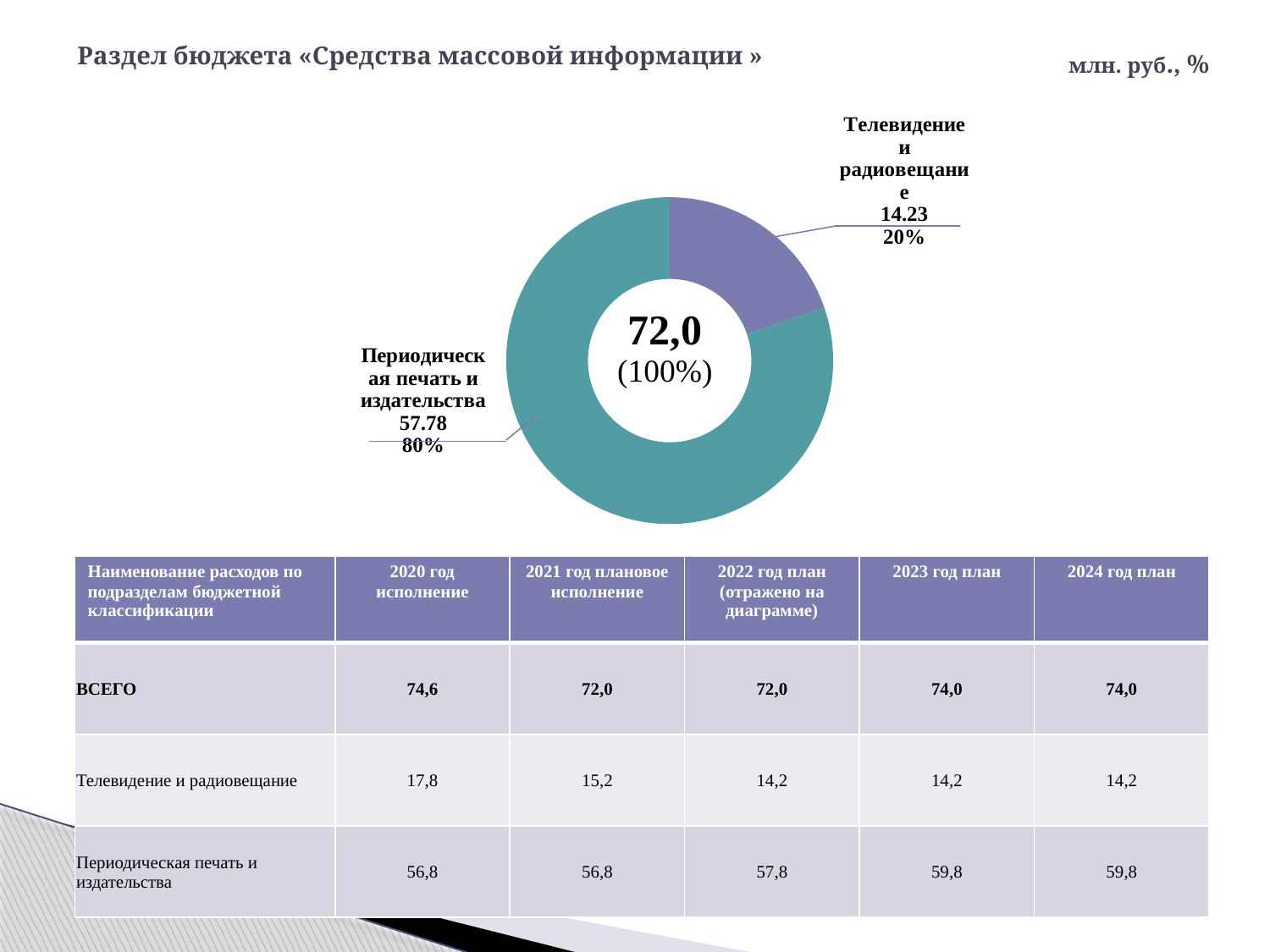
What share of the doughnut chart does Периодическая печать и издательства represent? 80% How many slices does the doughnut chart have? 2 What value is shown for Телевидение и радиовещание on the doughnut chart? 14.23 What value is shown for Периодическая печать и издательства on the doughnut chart? 57.78 What is the difference between the values for Периодическая печать и издательства and Телевидение и радиовещание on the doughnut chart? 43.55 What total value is shown in the centre of the doughnut chart? 72,0 (100%) What share of the doughnut chart does Телевидение и радиовещание represent? 20% Which slice of the doughnut chart is the largest? Периодическая печать и издательства Which is larger on the doughnut chart: Телевидение и радиовещание or Периодическая печать и издательства? Периодическая печать и издательства Which slice of the doughnut chart is the smallest? Телевидение и радиовещание What units are indicated in the top right corner of the slide for the chart? млн. руб., % What kind of chart is shown on the slide? Doughnut (pie) chart